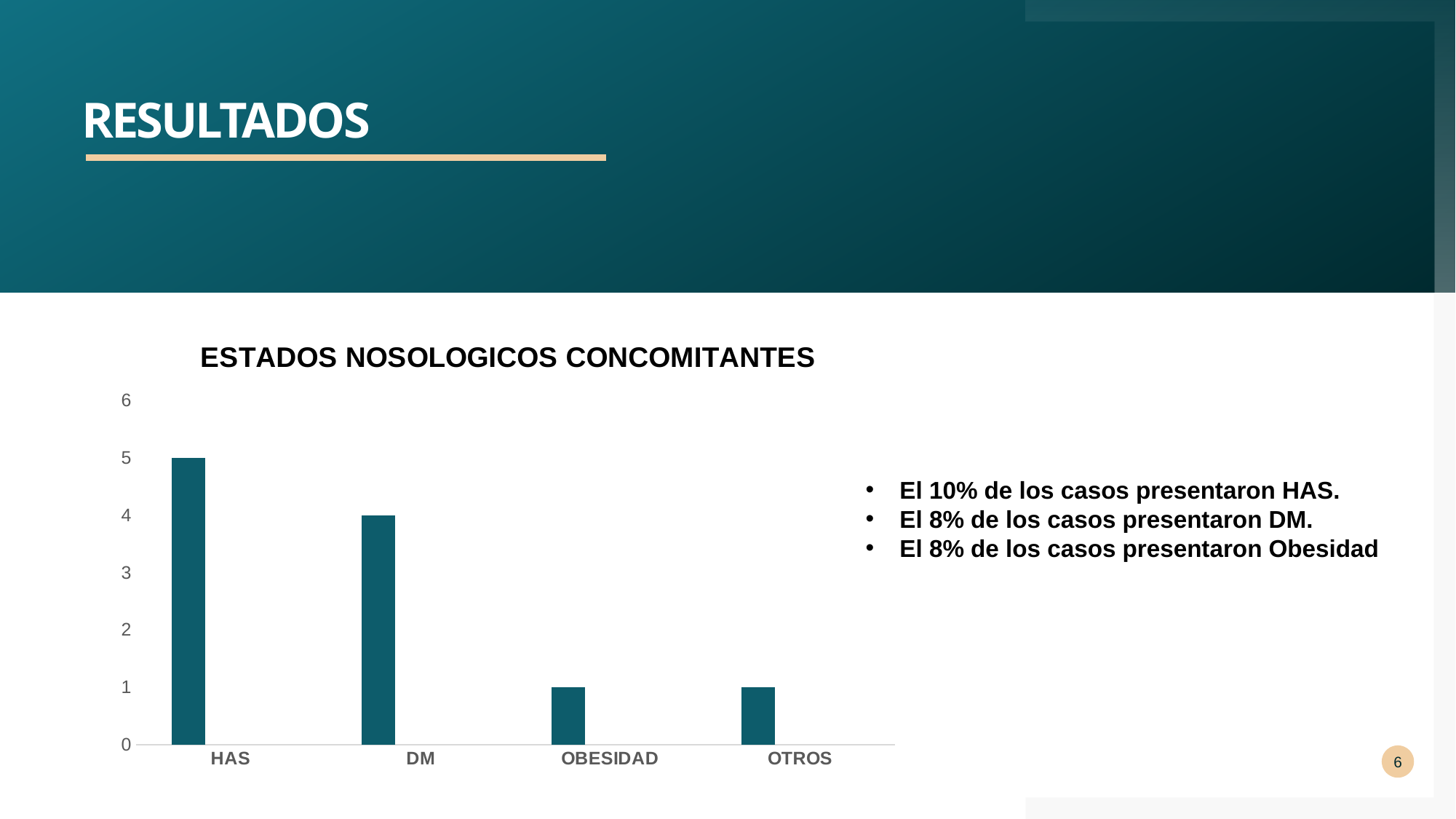
Which is larger, the value for HAS or the value for DM? HAS How many categories are shown on the x axis of the chart? 4 What is the value for OBESIDAD in the chart? 1 Which category has the highest value in the chart? HAS What is the difference between the values for HAS and DM? 1 What is the difference between the values for DM and OBESIDAD? 3 Is the value for HAS greater or less than 3? greater What is the value for OTROS in the chart? 1 What is the value for DM in the chart? 4 What is the value for HAS in the chart? 5 What is the title of the chart? ESTADOS NOSOLOGICOS CONCOMITANTES What kind of chart is shown on the slide? bar chart